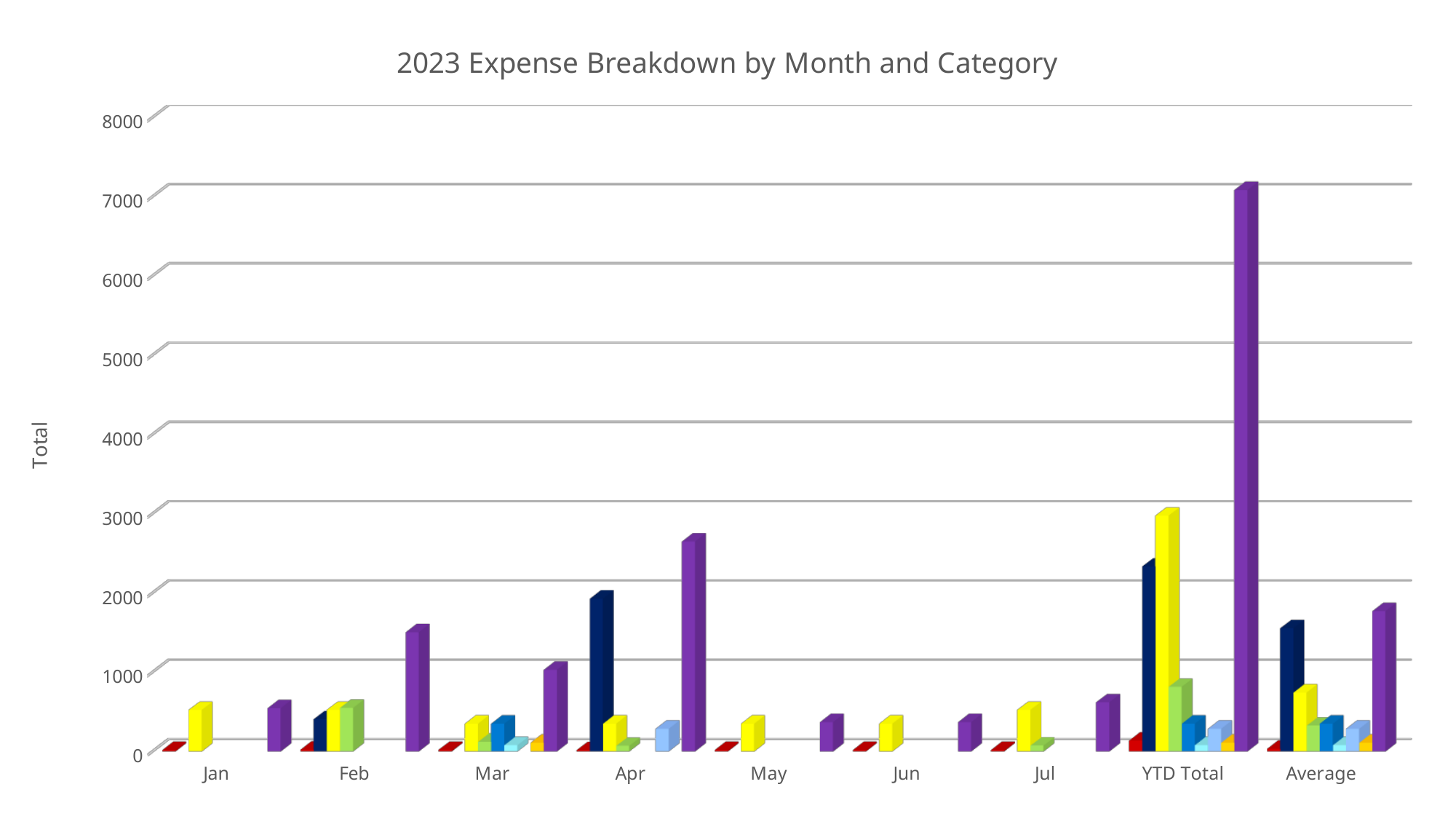
In the YTD Total category, which is larger, the yellow bar or the dark blue bar? yellow What is the label on the vertical axis? Total Is the value of the dark blue bar for YTD Total greater or less than 2000? greater Is the value of the purple bar for Feb greater or less than 1000? greater Which is larger, the purple bar for Apr or the purple bar for Feb? Apr Is the value of the purple bar for Average greater or less than 2000? less Which category contains the tallest bar in the chart? YTD Total What kind of chart is shown on the slide? bar chart How many categories are shown along the x axis? 9 What is the title of the chart? 2023 Expense Breakdown by Month and Category